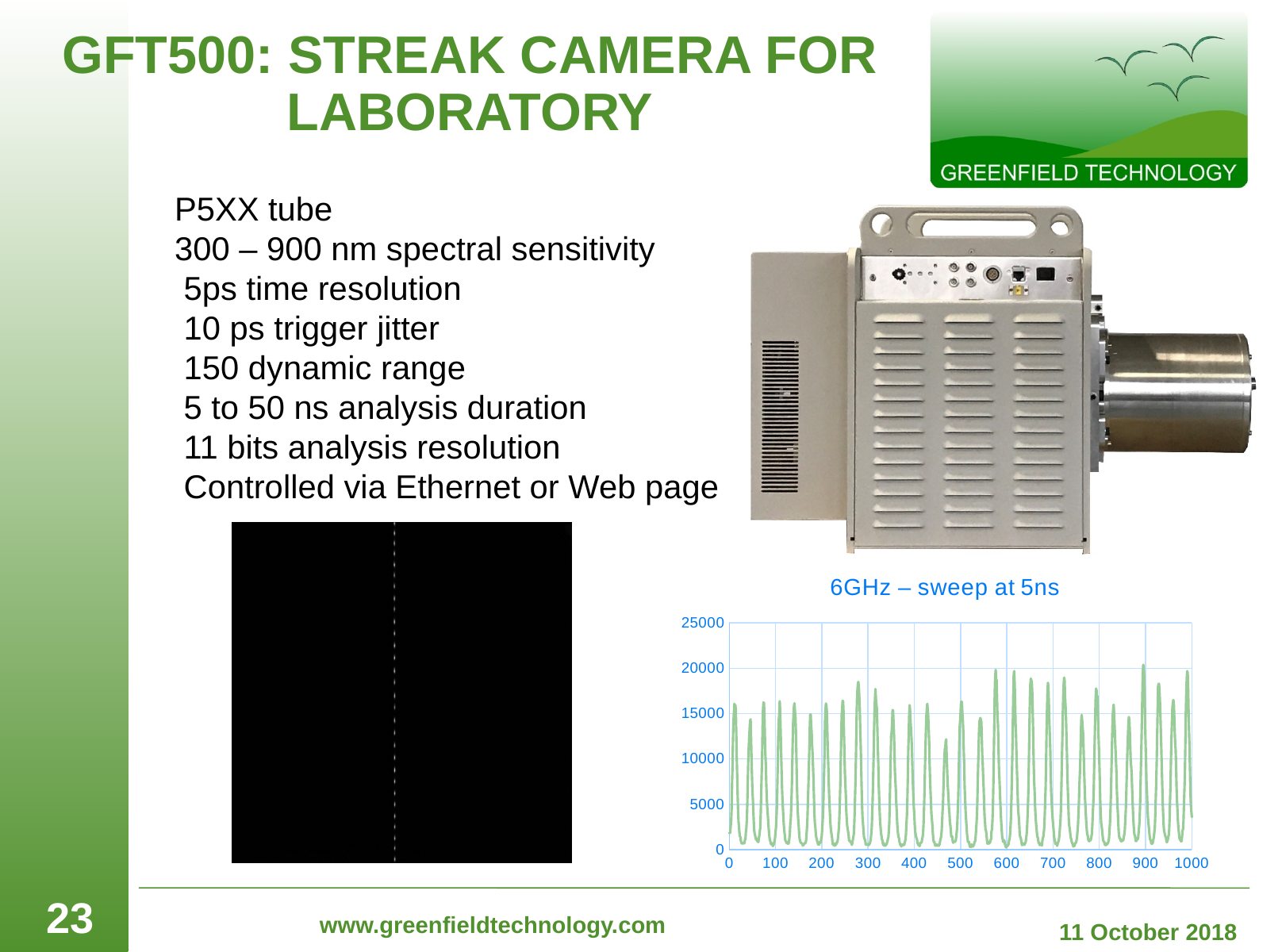
In the "6GHz – sweep at 5ns" chart, does the plotted signal steadily rise, steadily fall, or oscillate along the x axis? oscillate In the "6GHz – sweep at 5ns" chart, what is the highest value labelled on the y axis? 25000 What kind of chart is shown under the heading "6GHz – sweep at 5ns"? line chart In the "6GHz – sweep at 5ns" chart, is the peak near x = 470 greater or less than 15000? less In the "6GHz – sweep at 5ns" chart, is the highest peak of the plotted signal greater or less than 25000? less In the "6GHz – sweep at 5ns" chart, are the troughs of the plotted signal greater or less than 5000? less What is the title of the chart at the bottom right of the slide? 6GHz – sweep at 5ns